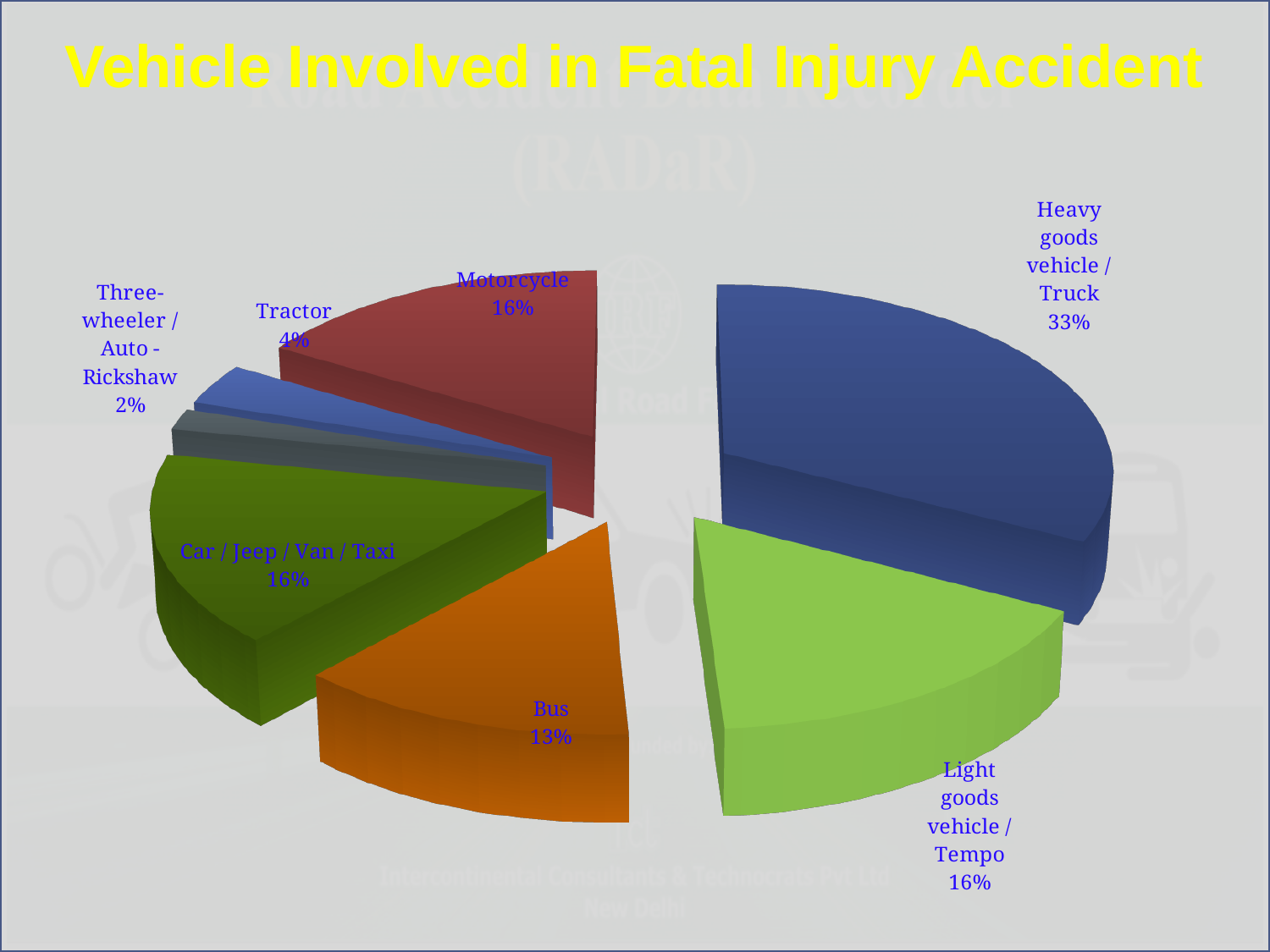
What is the difference in percentage points between Tractor and Three-wheeler / Auto-Rickshaw? 2 What percentage is shown for Tractor? 4% Which has a larger share, Bus or Car / Jeep / Van / Taxi? Car / Jeep / Van / Taxi What kind of chart is shown on the slide? pie chart Which vehicle category has the smallest share of the pie? Three-wheeler / Auto-Rickshaw What share of fatal injury accidents involved a Heavy goods vehicle / Truck? 33% What percentage is shown for Three-wheeler / Auto-Rickshaw? 2% What is the title of the chart? Vehicle Involved in Fatal Injury Accident What percentage is shown for Bus? 13% What percentage is shown for Motorcycle? 16% Which vehicle category has the largest share of the pie? Heavy goods vehicle / Truck What is the difference in percentage points between Heavy goods vehicle / Truck and Bus? 20